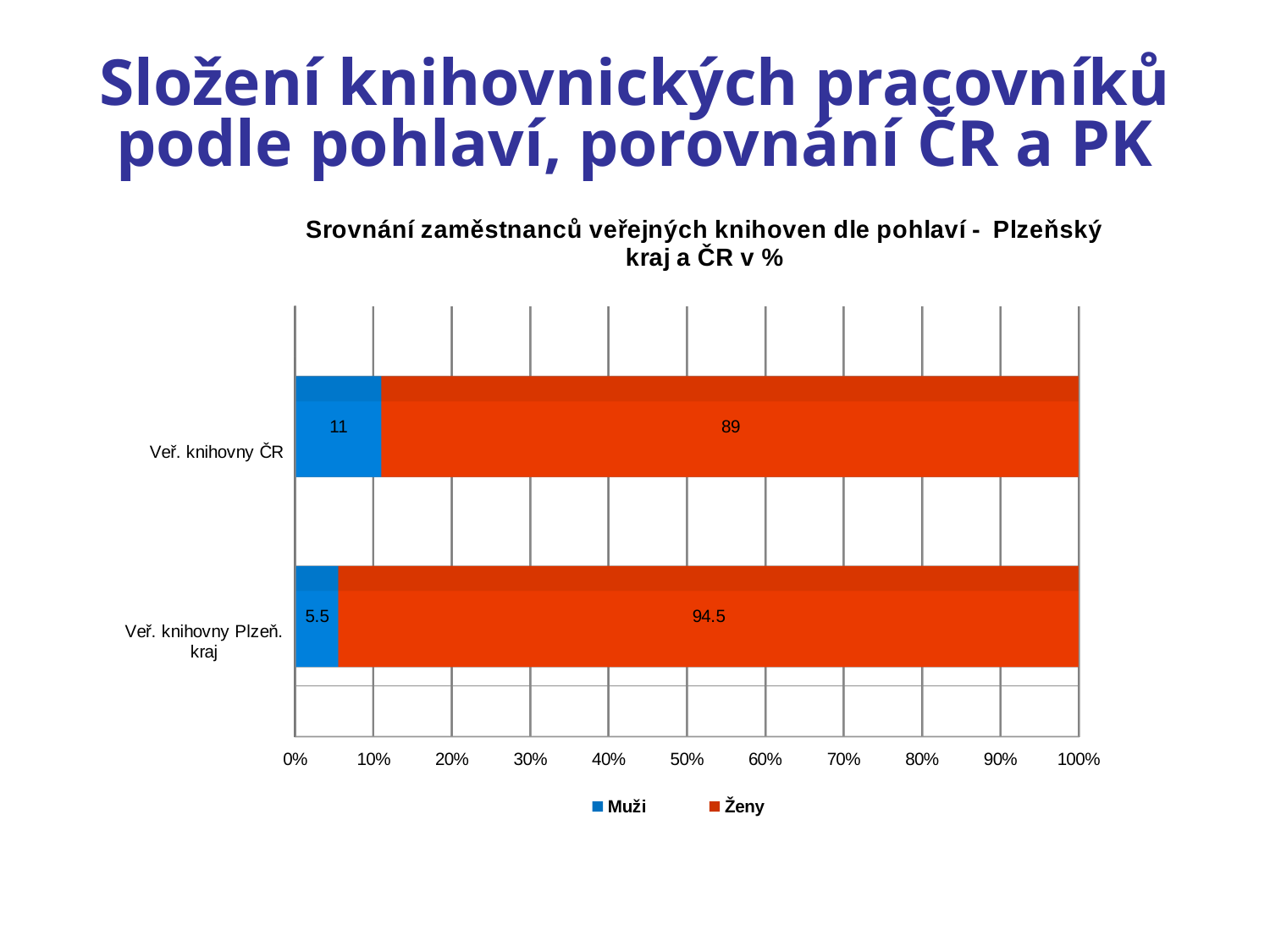
Which category has the lower value for Ženy? Veř. knihovny ČR What is the value for Muži in the Veř. knihovny Plzeň. kraj bar? 5.5 What is the difference between the Ženy values for Veř. knihovny Plzeň. kraj and Veř. knihovny ČR? 5.5 Is the Ženy value for Veř. knihovny ČR larger or smaller than the Ženy value for Veř. knihovny Plzeň. kraj? smaller Which category has the higher value for Muži? Veř. knihovny ČR What kind of chart is shown on the slide? stacked bar chart What is the difference between the Muži values for Veř. knihovny ČR and Veř. knihovny Plzeň. kraj? 5.5 What is the value for Ženy in the Veř. knihovny Plzeň. kraj bar? 94.5 What is the value for Ženy in the Veř. knihovny ČR bar? 89 How many categories are shown on the chart? 2 How many series does the legend list? 2 What is the value for Muži in the Veř. knihovny ČR bar? 11